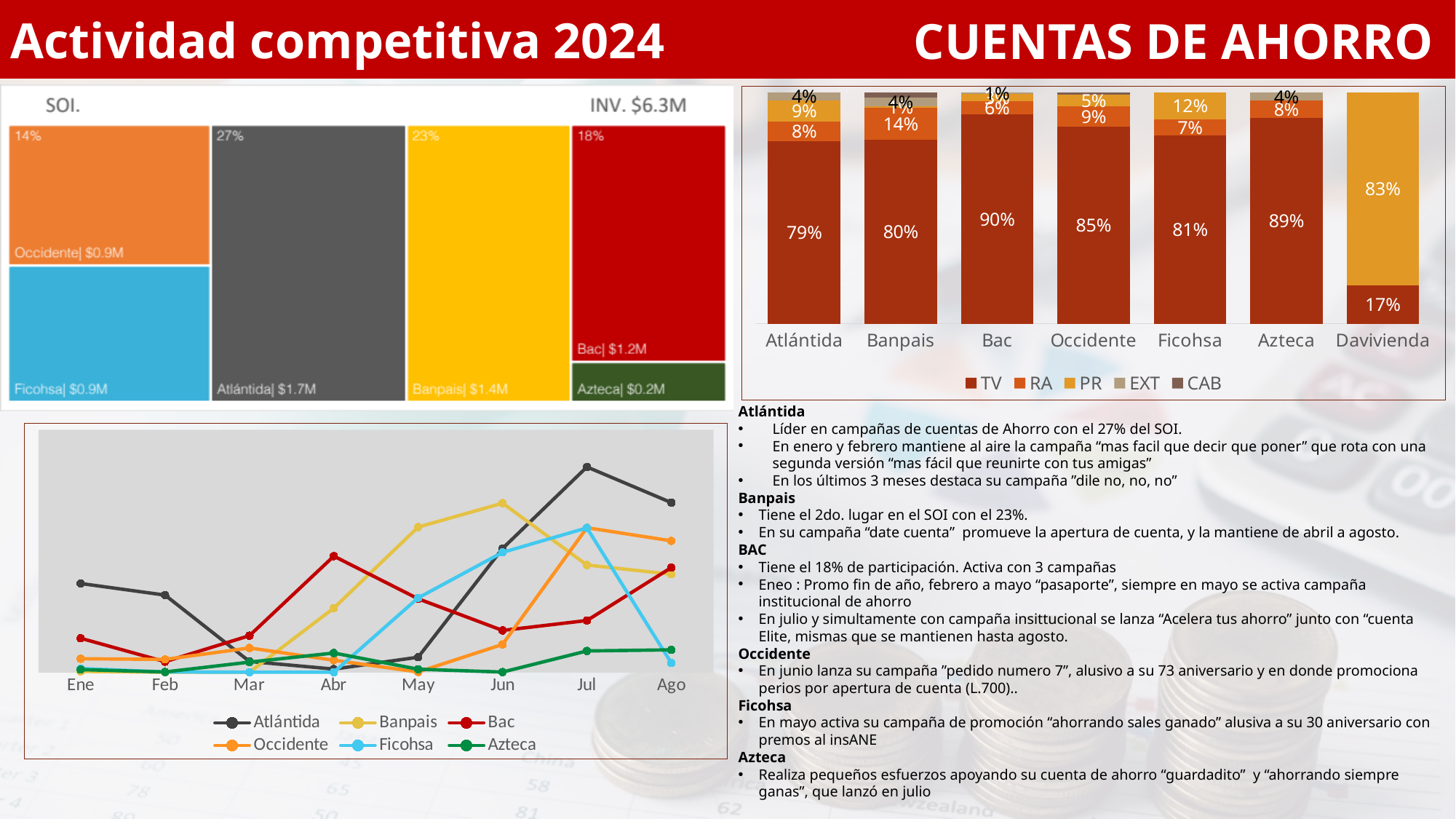
In the stacked bar chart at the top right, what is the PR share for Davivienda? 83% In the stacked bar chart at the top right, how many series does the legend list? 5 In the treemap at the top left, which is larger, the investment for Bac or for Occidente? Bac In the stacked bar chart at the top right, what is the difference between the TV shares of Azteca and Atlántida? 10% In the stacked bar chart at the top right, which bank has the lowest TV share? Davivienda In the stacked bar chart at the top right, which bank has the highest TV share? Bac In the line chart at the bottom left, how many months are shown on the x axis? 8 In the treemap at the top left, what percentage share is shown for Banpais? 23% In the stacked bar chart at the top right, what is the TV share for Bac? 90% In the stacked bar chart at the top right, how many banks are shown on the x axis? 7 What kind of chart is shown at the bottom left of the slide? Line chart In the treemap at the top left, what is the investment amount shown for Atlántida? $1.7M